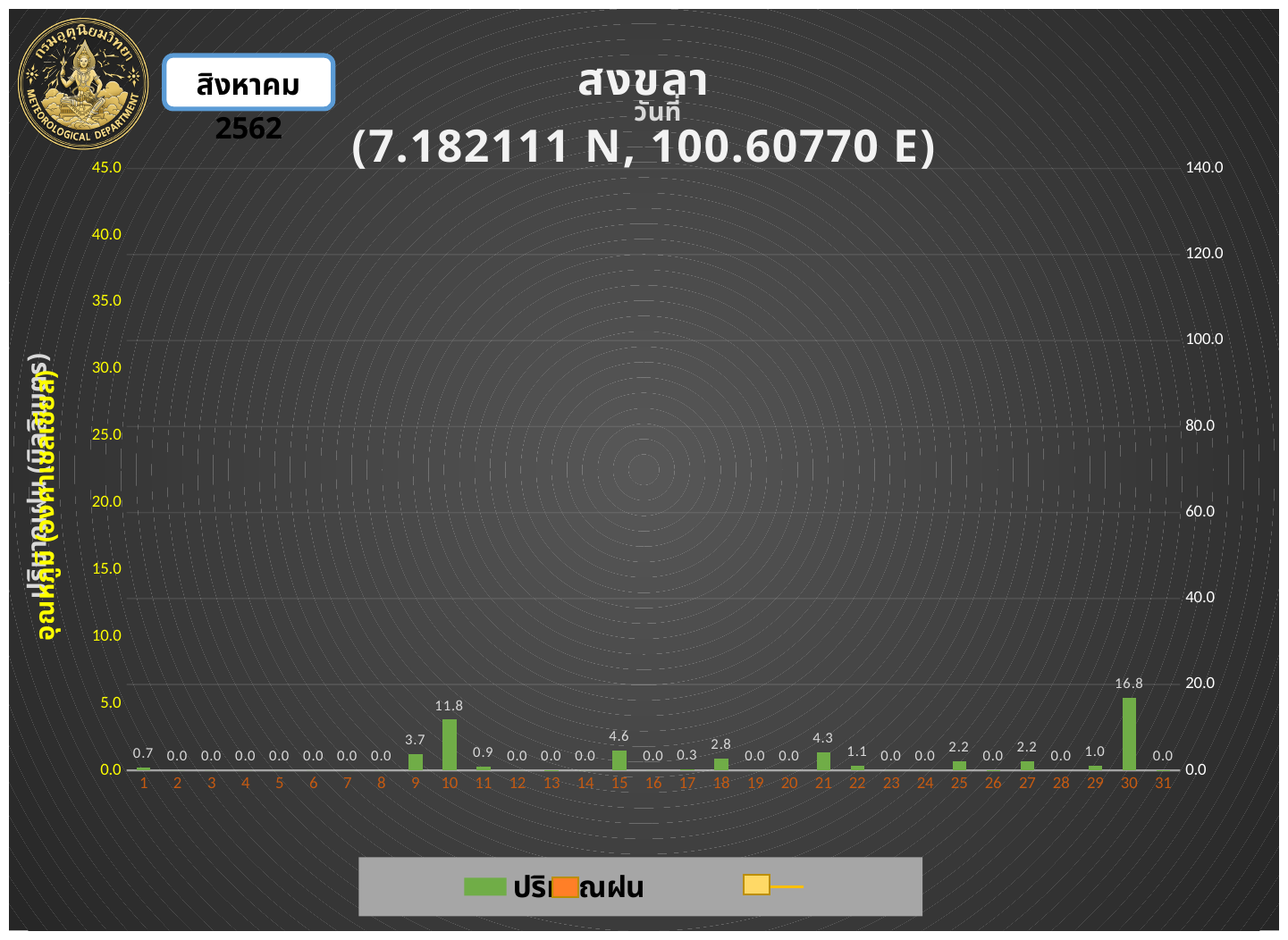
What is the difference between the rainfall values for day 15 and day 21? 0.3 What is the rainfall value (ปริมาณฝน) for day 10? 11.8 Which has a larger rainfall value, day 9 or day 21? day 21 How many days are shown on the x axis? 31 What is the rainfall value for day 15? 4.6 Which day has the highest rainfall value? 30 What colour are the bars for ปริมาณฝน in the legend? green What is the rainfall value for day 30? 16.8 What is the difference between the rainfall values for day 30 and day 10? 5.0 What is the rainfall value for day 17? 0.3 What kind of chart is shown on the slide? bar chart Which has a larger rainfall value, day 18 or day 25? day 18